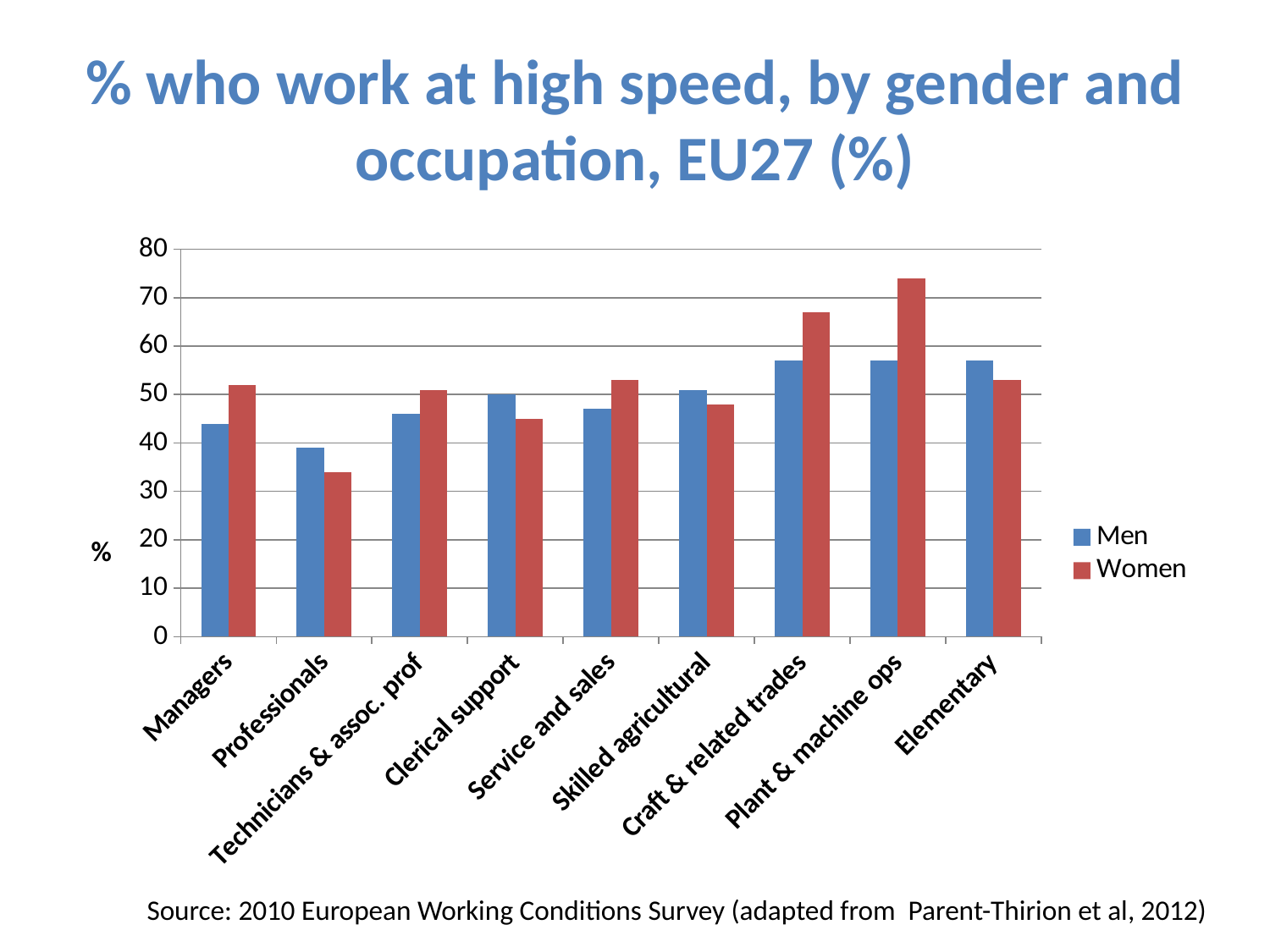
How many occupation categories are shown on the x axis? 9 For Managers, which is larger, the value for Men or for Women? Women Is the value for Women in Plant & machine ops greater or less than 70? greater Is the value for Women in Professionals greater or less than 40? less Is the value for Women in Craft & related trades greater or less than 60? greater For Professionals, which is larger, the value for Men or for Women? Men Which colour represents Women in the chart? red Which occupation has the lowest value for Women? Professionals How many series does the legend list? 2 Which occupation has the lowest value for Men? Professionals Which occupation has the highest value for Women? Plant & machine ops What kind of chart is shown on the slide? bar chart